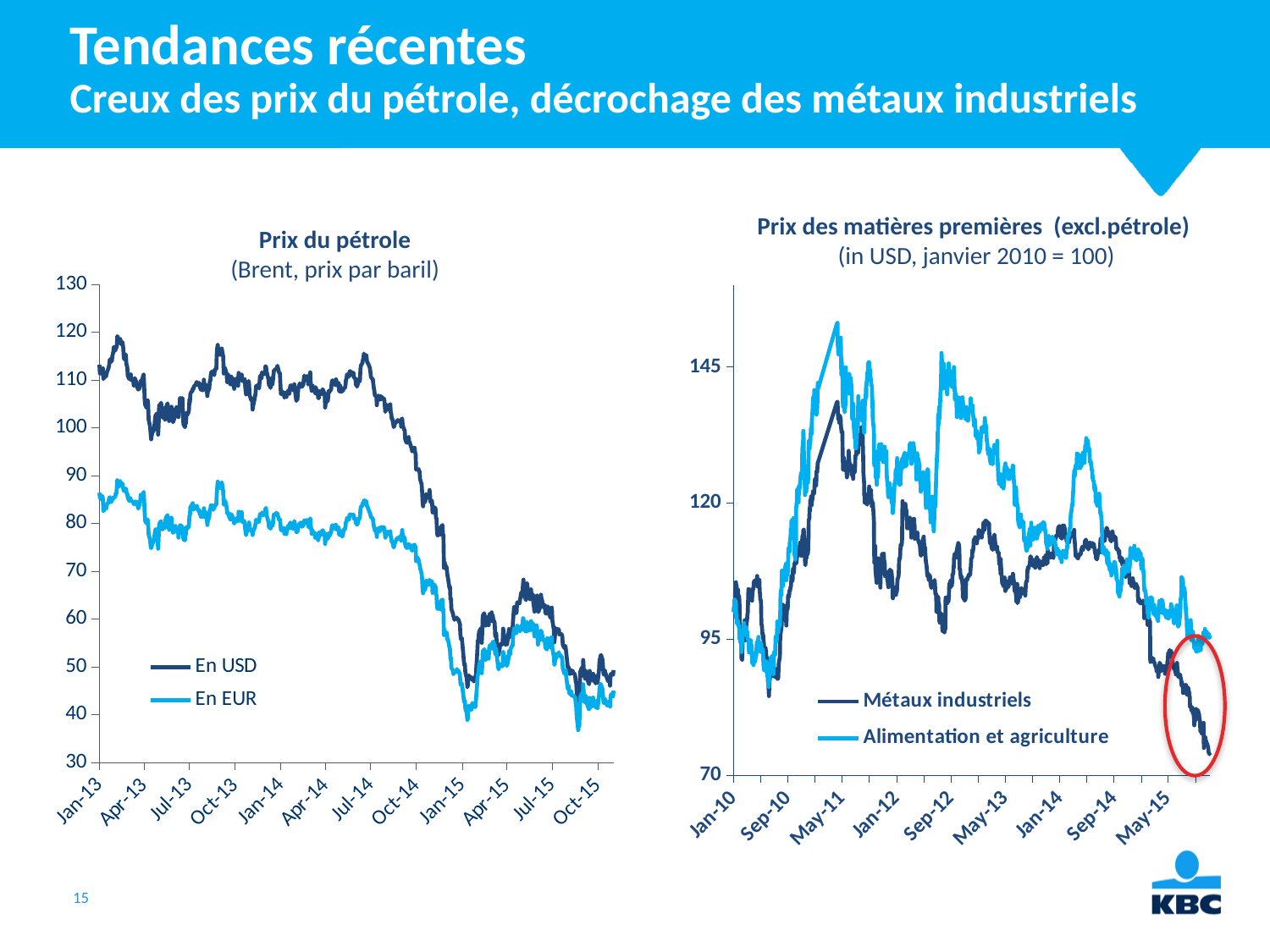
What kind of chart is the "Prix du pétrole" chart on the left? line chart In the "Prix du pétrole" chart, is the value for En EUR at Jan-13 greater or less than 90? less In the "Prix des matières premières (excl.pétrole)" chart, do the values for Métaux industriels rise or fall from Jan-14 to the end of the series? fall In the "Prix des matières premières (excl.pétrole)" chart, which series is higher at Sep-12, Métaux industriels or Alimentation et agriculture? Alimentation et agriculture In the "Prix des matières premières (excl.pétrole)" chart, is the value for Alimentation et agriculture at May-11 greater or less than 145? greater What kind of chart is the "Prix des matières premières (excl.pétrole)" chart on the right? line chart In the "Prix du pétrole" chart, which series is higher at Jan-14, En USD or En EUR? En USD How many series does the legend of the "Prix du pétrole" chart list? 2 How many series does the legend of the "Prix des matières premières (excl.pétrole)" chart list? 2 In the "Prix du pétrole" chart, do the values for En USD rise or fall overall from Jul-14 to Jan-15? fall In the "Prix du pétrole" chart, is the value for En USD at Jan-13 greater or less than 100? greater